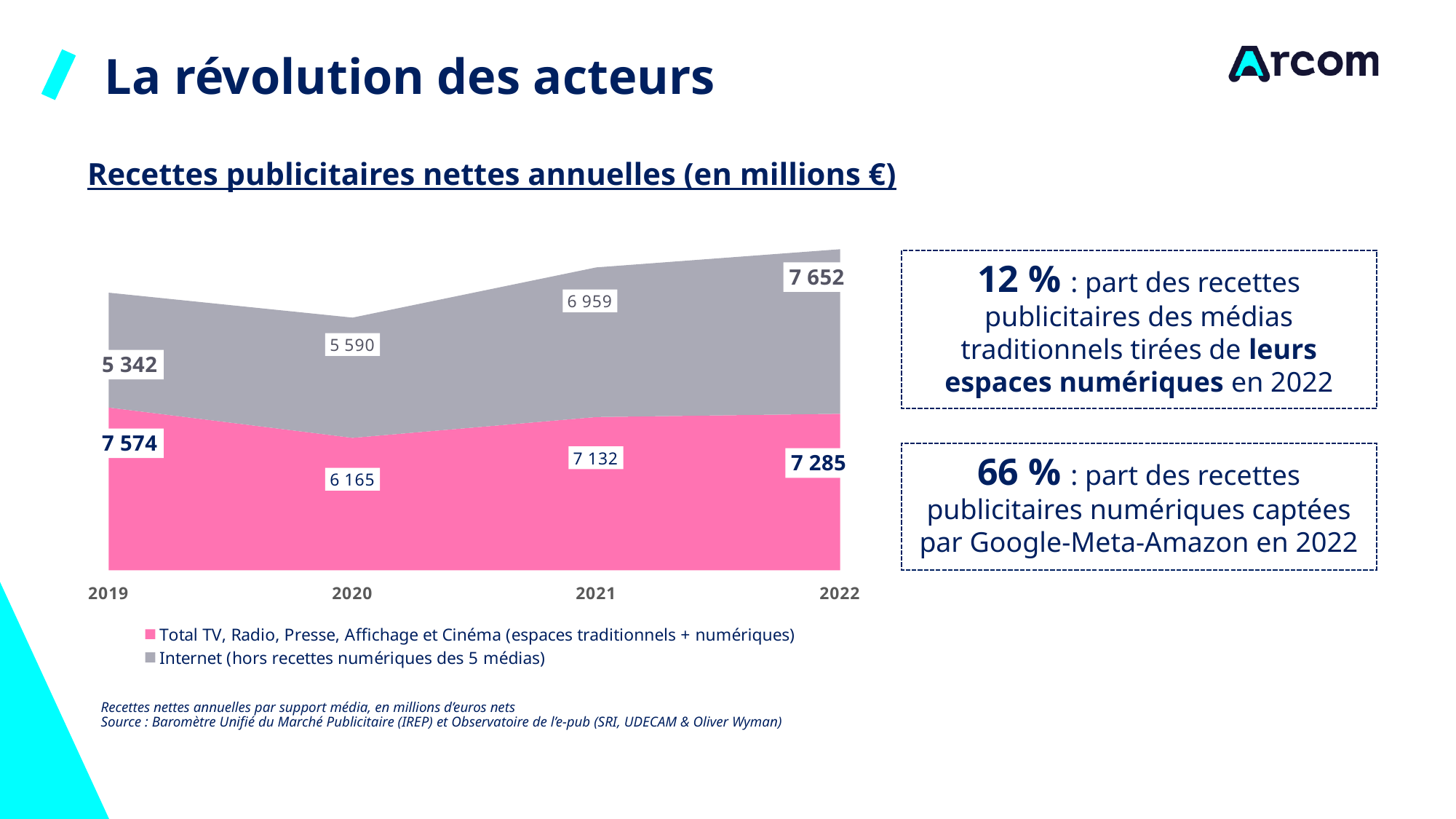
What is the value for Total TV, Radio, Presse, Affichage et Cinéma in 2020? 6 165 Does the Internet (hors recettes numériques des 5 médias) series rise or fall from 2019 to 2022? Rise What is the value for Internet (hors recettes numériques des 5 médias) in 2022? 7 652 What is the value for Internet (hors recettes numériques des 5 médias) in 2019? 5 342 In which year is the Internet (hors recettes numériques des 5 médias) series lowest? 2019 In which year is the Total TV, Radio, Presse, Affichage et Cinéma series highest? 2019 In 2022, which series has the larger value: Total TV, Radio, Presse, Affichage et Cinéma or Internet? Internet What is the combined total of the two series in 2021? 14 091 What is the difference between the Internet value in 2022 and the Internet value in 2019? 2 310 How many series does the legend list? 2 How many years are shown on the x axis? 4 What kind of chart is shown on the slide? Stacked area chart